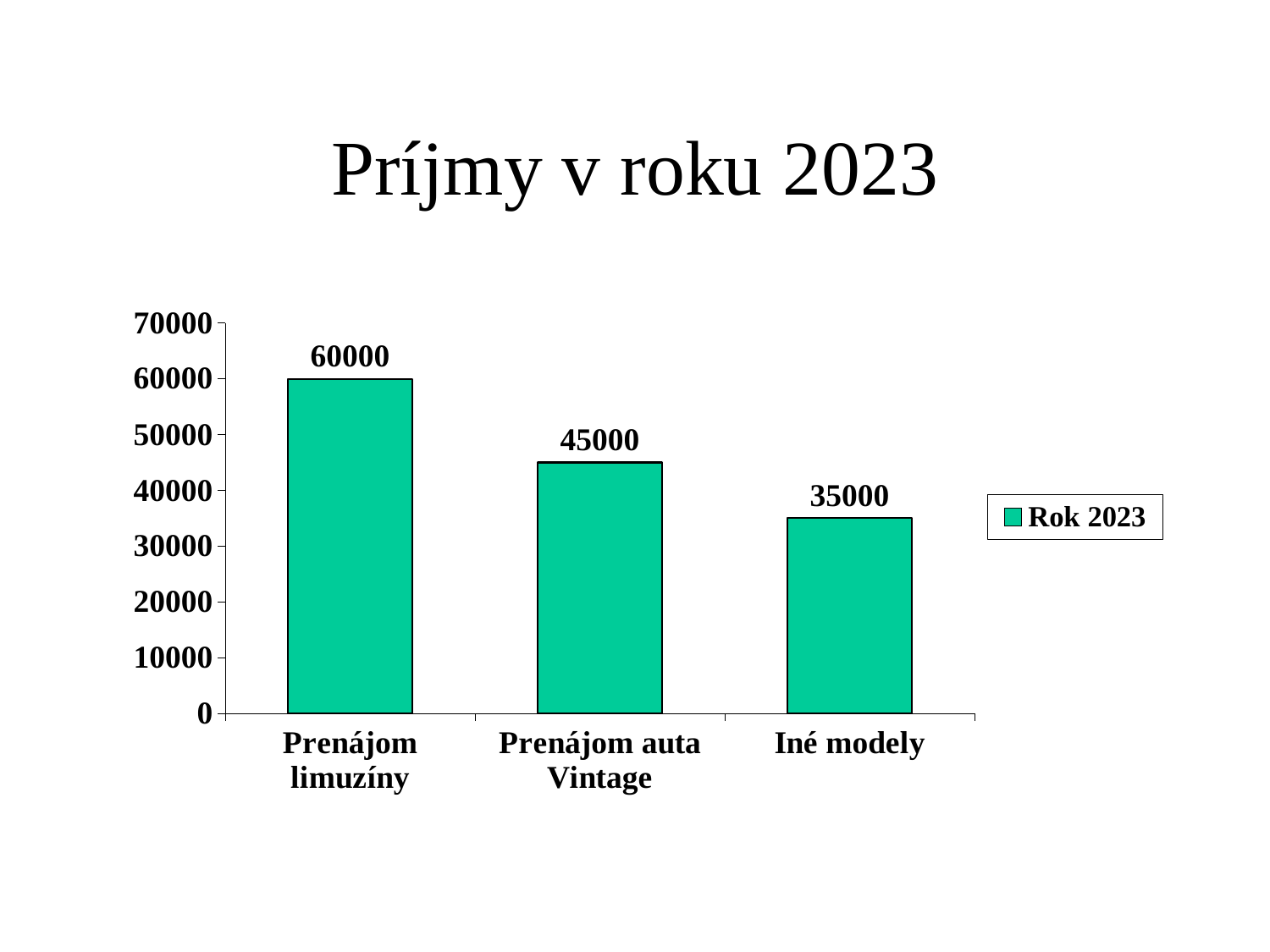
What is the value for Iné modely? 35000 What is the value for Prenájom limuzíny? 60000 Which category has the highest value? Prenájom limuzíny What is the difference between the values for Prenájom limuzíny and Iné modely? 25000 How many categories are shown in the chart? 3 How many series does the legend list? 1 Which is larger, the value for Prenájom auta Vintage or the value for Iné modely? Prenájom auta Vintage Is the value for Prenájom auta Vintage greater or less than 40000? greater What kind of chart is shown on the slide? bar chart What is the difference between the values for Prenájom auta Vintage and Iné modely? 10000 What is the value for Prenájom auta Vintage? 45000 Which category has the lowest value? Iné modely